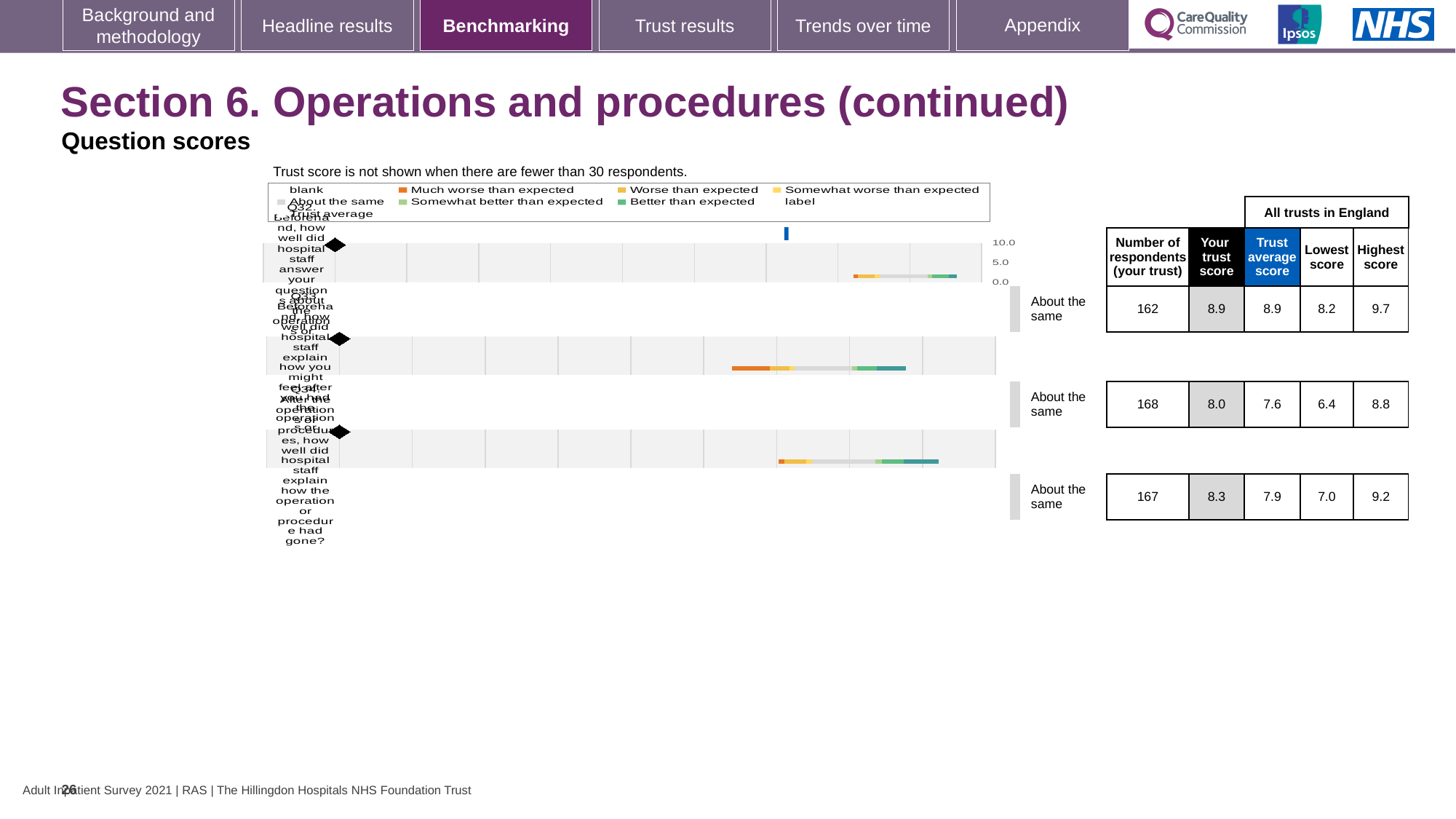
How many question rows are shown in the benchmarking chart? 3 In the table, what is the number of respondents for the first question row? 162 What benchmark category label is shown next to each of the three question rows? About the same For the second question row, what is the difference between 'Your trust score' and the 'Trust average score'? 0.4 In the table, what is the 'Highest score' for the second question row? 8.8 In the table, what is the 'Lowest score' for the third question row? 7.0 What kind of chart is used to show the benchmarking results? Bar chart What is the lowest value in the 'Lowest score' column of the table? 6.4 In the table, what is the 'Trust average score' for the second question row? 7.6 For the third question row, which is larger: 'Your trust score' or the 'Trust average score'? Your trust score (8.3) Which question row has the highest 'Your trust score' in the table? The first row (8.9) In the table, what is 'Your trust score' for the first question row? 8.9